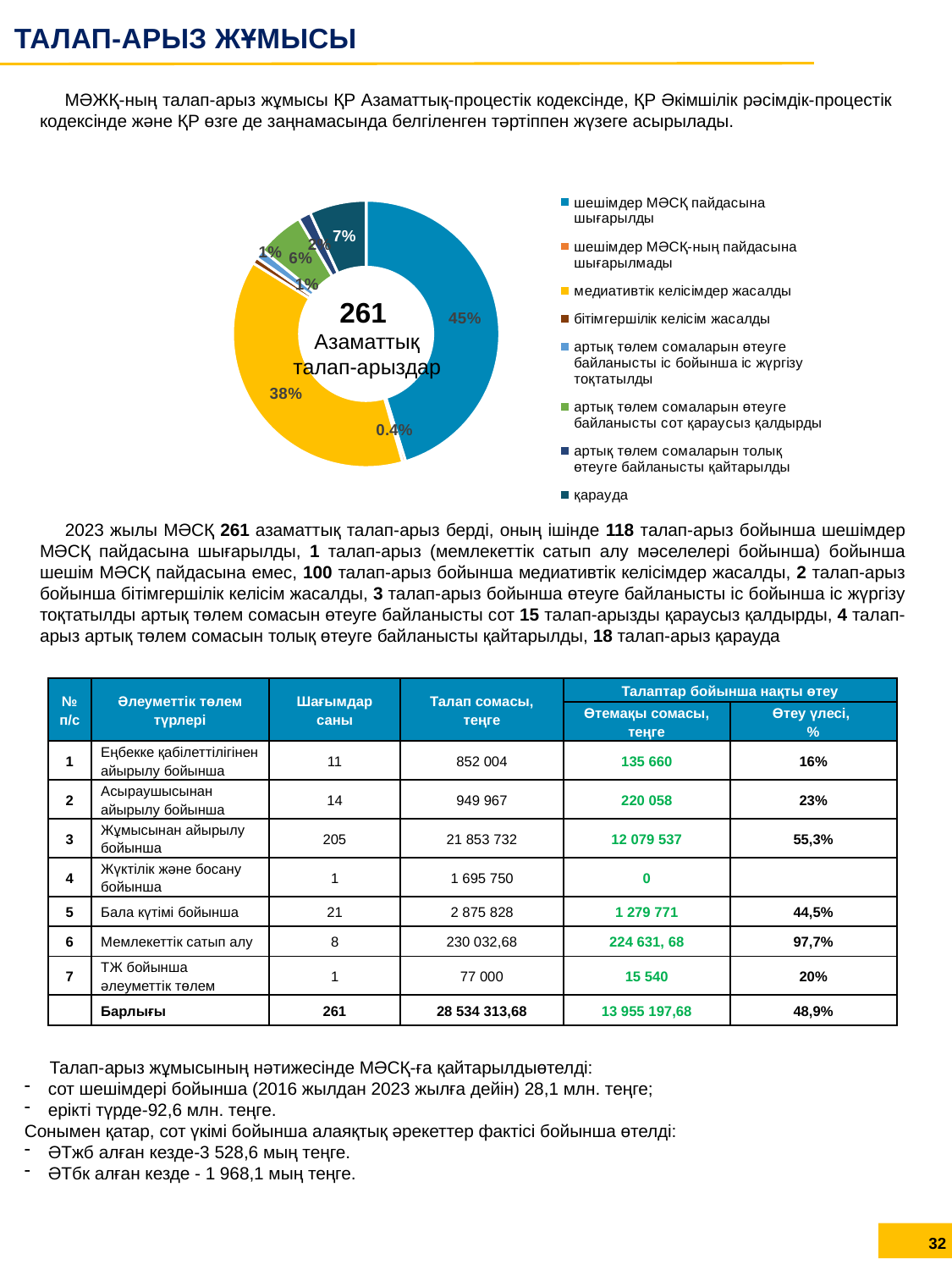
What share of the pie chart is labelled for 'артық төлем сомаларын өтеуге байланысты сот қараусыз қалдырды'? 6% What share of the pie chart is labelled for 'қарауда'? 7% Which category has the largest slice in the pie chart? шешімдер МӘСҚ пайдасына шығарылды Which slice is larger in the pie chart: 'қарауда' or 'артық төлем сомаларын толық өтеуге байланысты қайтарылды'? қарауда Which category has the smallest slice in the pie chart? шешімдер МӘСҚ-ның пайдасына шығарылмады How many categories does the legend of the pie chart list? 8 What share of the pie chart is labelled for 'медиативтік келісімдер жасалды'? 38% What kind of chart is shown on the slide? doughnut chart What share of the pie chart is labelled for 'шешімдер МӘСҚ пайдасына шығарылды'? 45% What share of the pie chart is labelled for 'шешімдер МӘСҚ-ның пайдасына шығарылмады'? 0.4% What number is printed in the centre of the pie chart? 261 By how many percentage points does the 'шешімдер МӘСҚ пайдасына шығарылды' slice exceed the 'медиативтік келісімдер жасалды' slice? 7